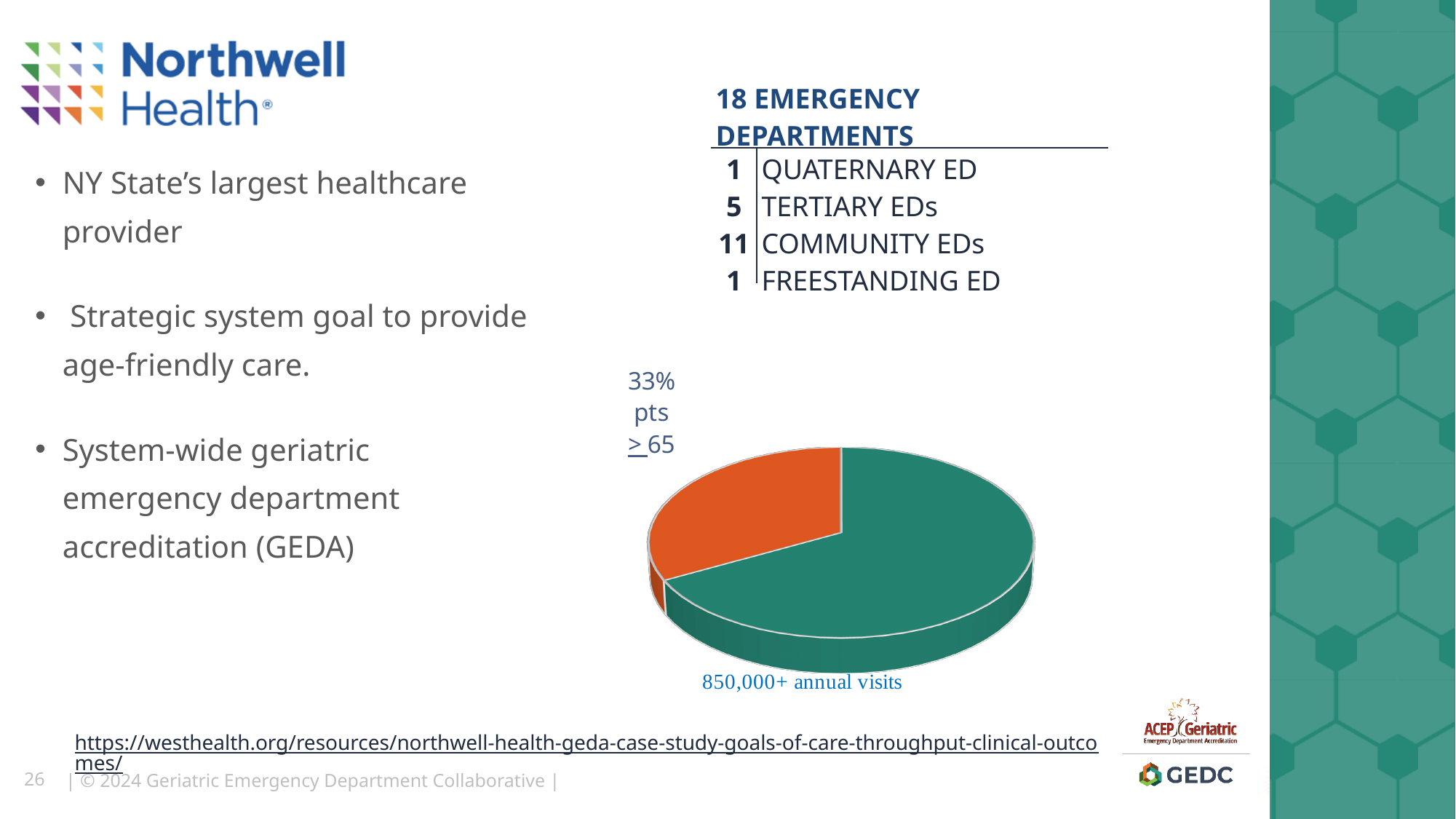
What share of the pie chart is labelled as patients aged 65 or older (pts ≥ 65)? 33% What percentage of the pie chart does the green slice represent, given the orange slice is 33%? 67% What kind of chart is shown on the slide? pie chart How many slices does the pie chart have? 2 Which slice of the pie chart is larger, the orange slice or the green slice? green What colour is the slice labelled '33% pts ≥ 65' in the pie chart? orange Is the slice for patients aged 65 or older less than half of the pie chart? yes What text appears directly below the pie chart? 850,000+ annual visits